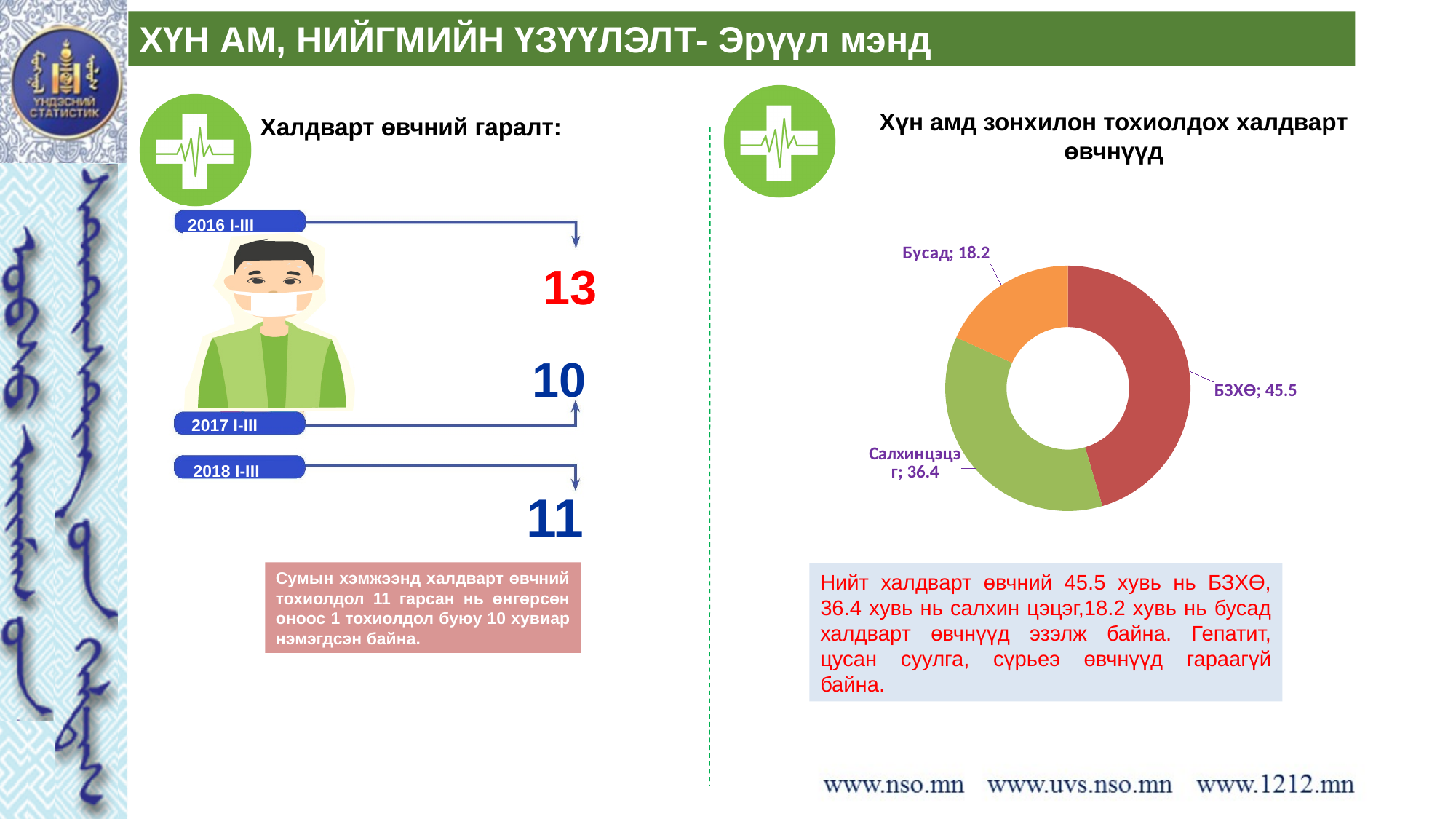
In the doughnut chart on the right, how many slices (categories) are there? 3 In the doughnut chart on the right, which category has the smallest slice? Бусад In the doughnut chart on the right, what is the difference between the values for БЗХӨ and Салхинцэцэг? 9.1 In the doughnut chart on the right, what is the value for Салхинцэцэг? 36.4 In the doughnut chart on the right, which category has the largest slice? БЗХӨ What kind of chart is shown on the right side of the slide under the title 'Хүн амд зонхилон тохиолдох халдварт өвчнүүд'? Doughnut (pie) chart In the doughnut chart on the right, what is the value for Бусад? 18.2 In the doughnut chart on the right, which is larger: the value for Салхинцэцэг or the value for Бусад? Салхинцэцэг In the doughnut chart on the right, what colour is the БЗХӨ slice? Red In the infographic on the left ('Халдварт өвчний гаралт'), what is the value shown for 2016 I-III? 13 In the doughnut chart on the right, what is the value for БЗХӨ? 45.5 In the doughnut chart on the right, what is the difference between the values for Салхинцэцэг and Бусад? 18.2